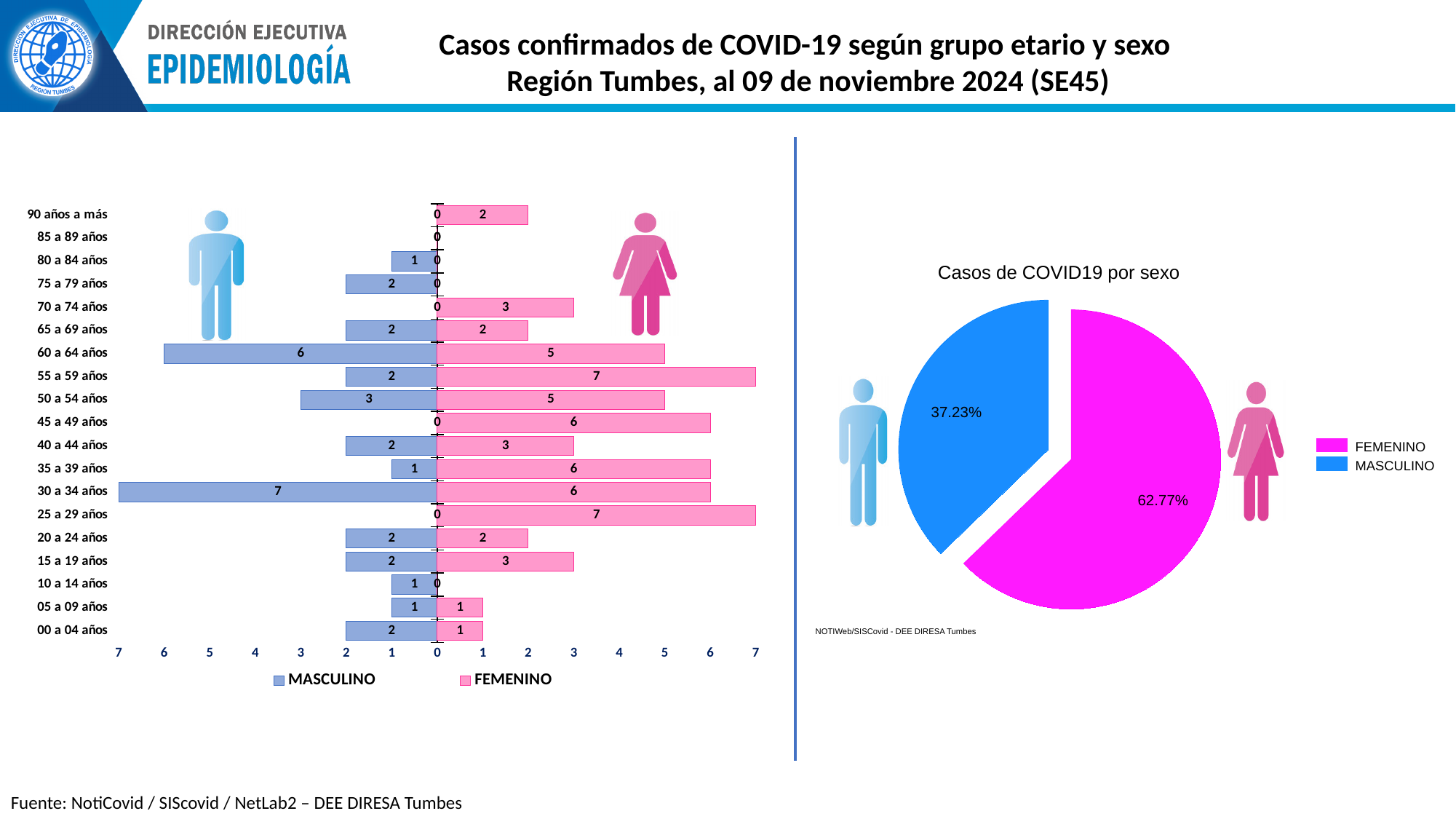
In the left bar chart, what is the total of MASCULINO and FEMENINO cases for the 50 a 54 años age group? 8 In the left bar chart, what is the difference between the FEMENINO and MASCULINO values for the 55 a 59 años age group? 5 In the pie chart 'Casos de COVID19 por sexo', what share of cases is MASCULINO? 37.23% How many age groups are shown in the left bar chart? 19 In the left bar chart, what is the FEMENINO value for the 55 a 59 años age group? 7 What type of chart is the chart on the left of the slide? Bar chart In the left bar chart, what is the MASCULINO value for the 30 a 34 años age group? 7 In the left bar chart, which age group has the highest MASCULINO value? 30 a 34 años In the left bar chart, what is the FEMENINO value for the 45 a 49 años age group? 6 How many series does the legend of the left bar chart list? 2 In the left bar chart, which is larger for the 60 a 64 años age group, the MASCULINO or the FEMENINO value? MASCULINO In the pie chart 'Casos de COVID19 por sexo', what share of cases is FEMENINO? 62.77%